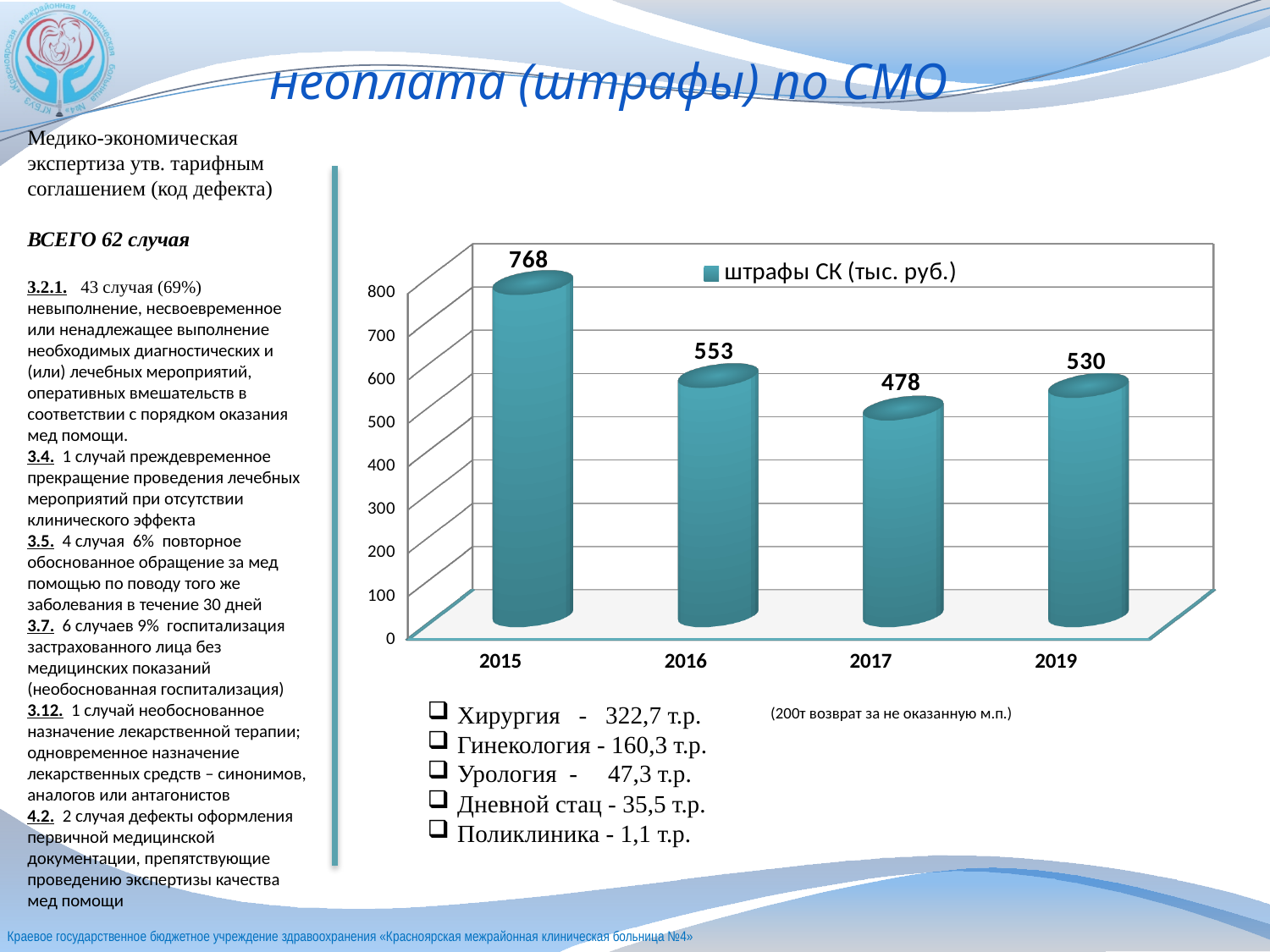
What kind of chart is shown on the slide? bar chart What is the value for 2017 in the chart? 478 What is the value for 2019 in the chart? 530 What is the difference between the values for 2015 and 2016? 215 Is the value for 2017 greater or less than 500? less How many years are shown on the x axis of the chart? 4 What is the value for 2015 in the chart? 768 What series name does the chart legend show? штрафы СК (тыс. руб.) What is the difference between the values for 2019 and 2017? 52 Which year has the lowest value in the chart? 2017 Which is larger, the value for 2016 or the value for 2019? 2016 Which year has the highest value in the chart? 2015